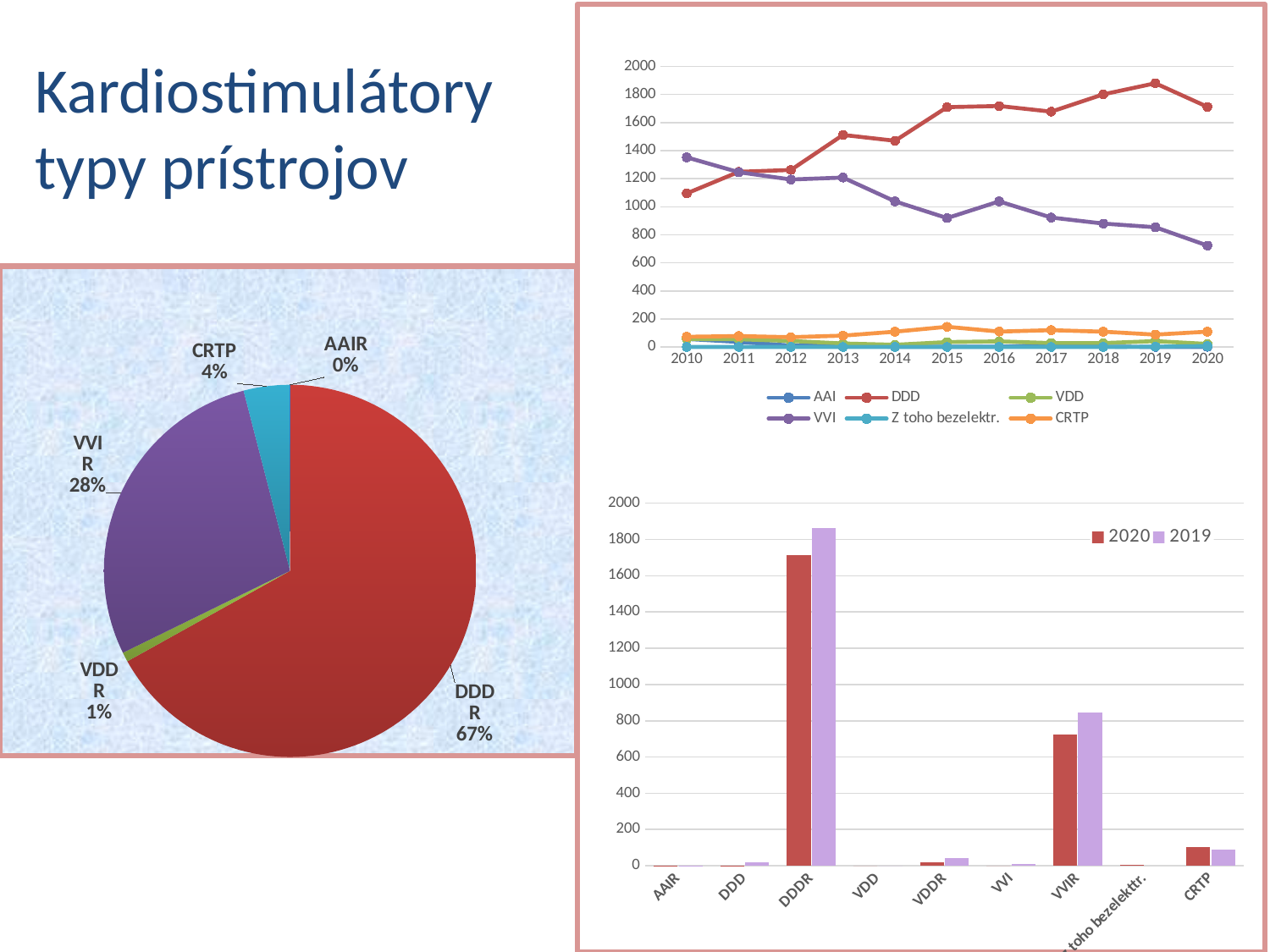
In the line chart at the top right, is the value for DDD in 2020 greater or less than 1600? greater In the bar chart at the bottom right, which is larger for DDDR: the 2020 value or the 2019 value? 2019 In the pie chart on the left, how many slices are labelled? 5 In the pie chart on the left, which category has the largest slice? DDDR In the line chart at the top right, is the value for VVI in 2020 greater or less than 800? less In the line chart at the top right, does the VVI series rise or fall from 2010 to 2020? fall In the pie chart on the left, what is the difference in percentage points between the DDDR and VVIR slices? 39 percentage points What kind of chart is the chart at the bottom right? bar chart In the bar chart at the bottom right, which category has the highest bars? DDDR In the pie chart on the left, what share does DDDR have? 67% In the pie chart on the left, what share does VVIR have? 28% How many series does the legend of the line chart at the top right list? 6